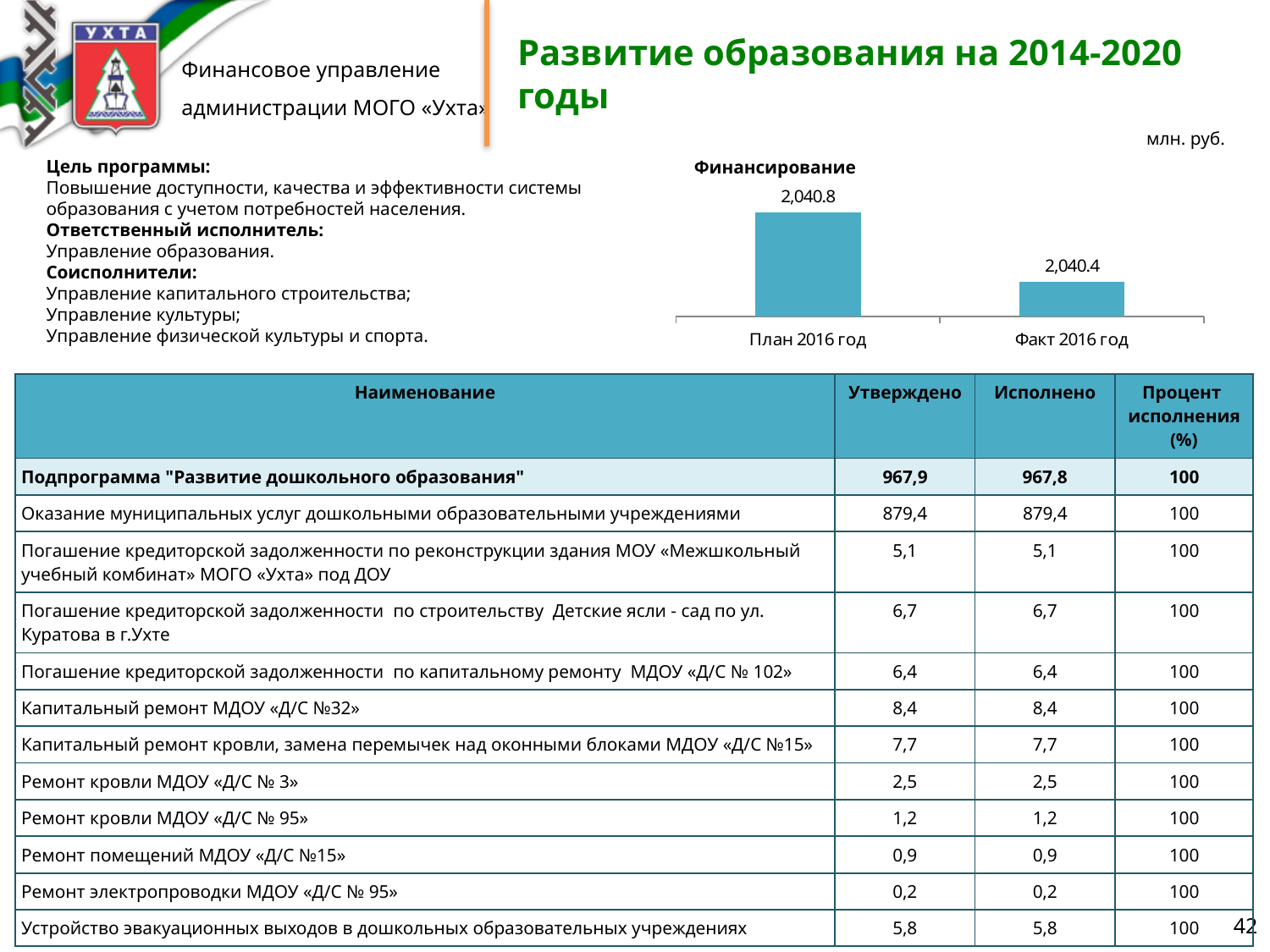
In the Финансирование chart, which is larger: План 2016 год or Факт 2016 год? План 2016 год What is the title of the chart on the slide? Финансирование What is the value for Факт 2016 год in the Финансирование chart? 2,040.4 Which category has the highest value in the Финансирование chart? План 2016 год Do the values in the Финансирование chart rise or fall from План 2016 год to Факт 2016 год? Fall What type of chart is the Финансирование chart? Bar chart Which category has the lowest value in the Финансирование chart? Факт 2016 год How many categories are shown in the Финансирование chart? 2 What is the value for План 2016 год in the Финансирование chart? 2,040.8 What unit is indicated for the values in the chart? млн. руб. What is the difference between the План 2016 год and Факт 2016 год values in the Финансирование chart? 0.4